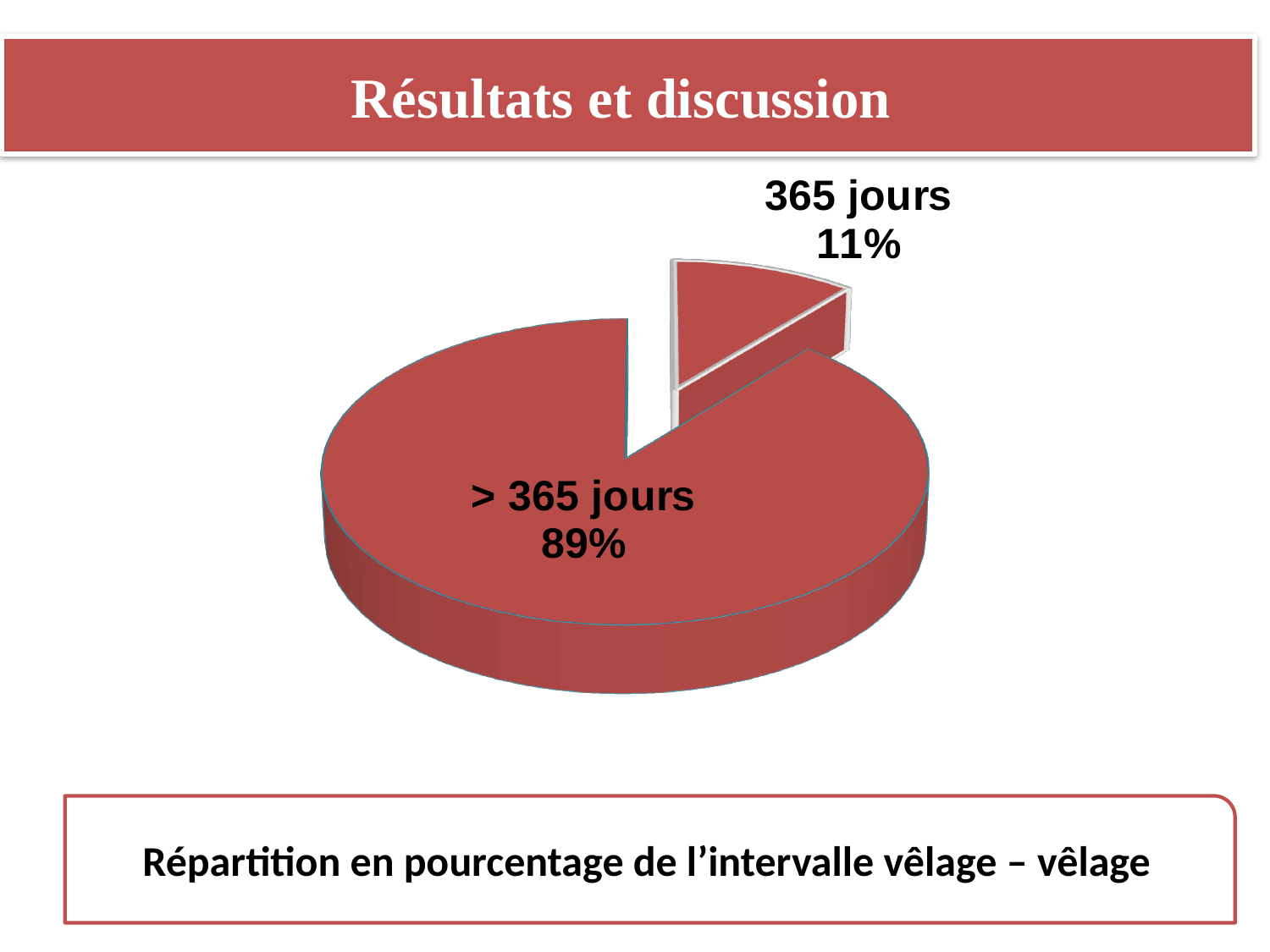
Which slice is larger, "365 jours" or "> 365 jours"? > 365 jours Which slice is pulled out (exploded) from the pie? 365 jours What is the difference in percentage points between the "> 365 jours" and "365 jours" slices? 78 Which category has the smallest share of the pie? 365 jours What is the caption below the chart? Répartition en pourcentage de l'intervalle vêlage – vêlage How many slices does the pie chart have? 2 What share of the pie does the "> 365 jours" slice represent? 89% What share of the pie does the "365 jours" slice represent? 11% What kind of chart is shown on the slide? Pie chart Which category has the largest share of the pie? > 365 jours Is the share for "> 365 jours" greater or less than 80%? greater Is the share for "365 jours" greater or less than 20%? less